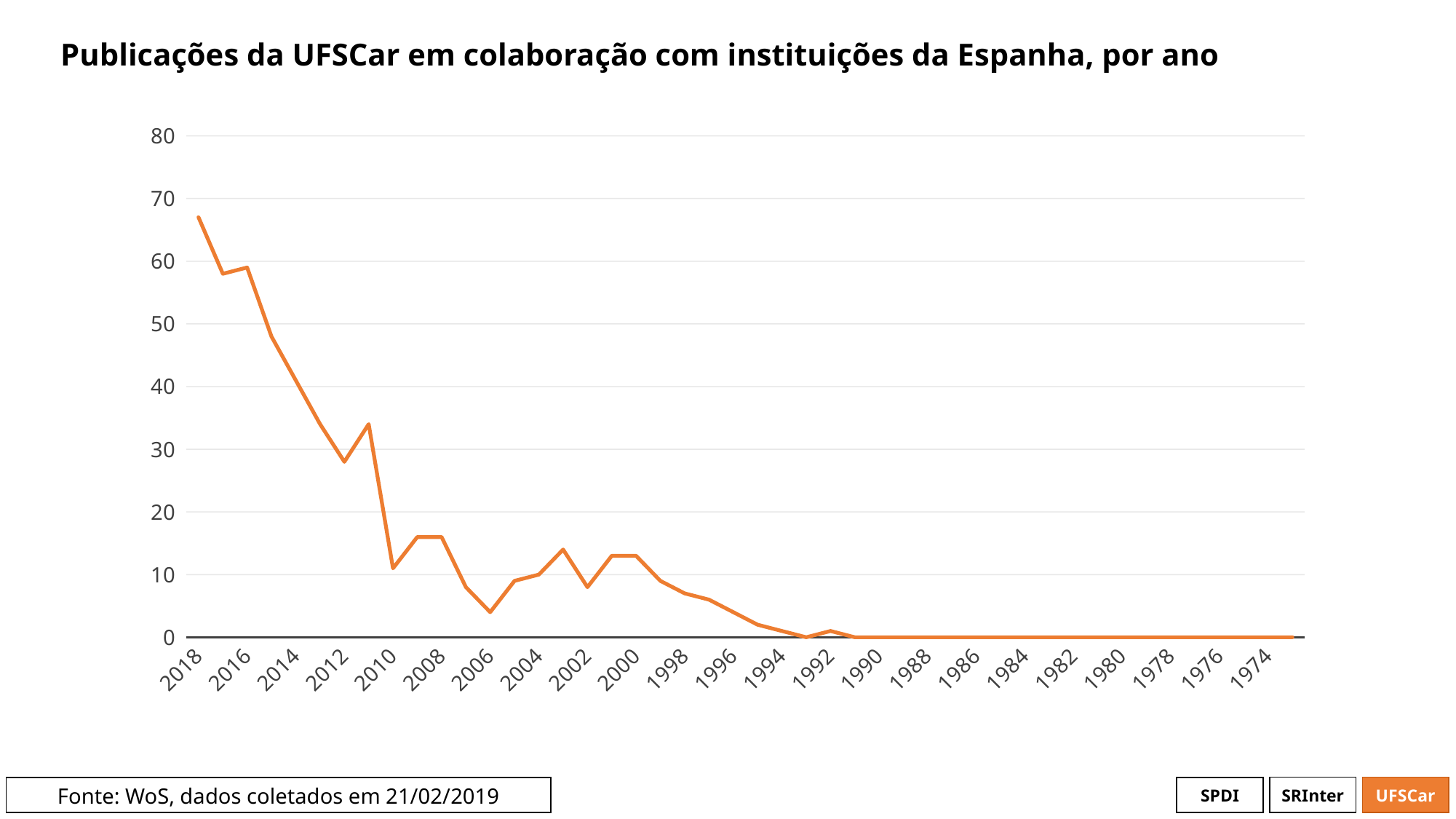
Do the values rise or fall moving from left (2018) to right (1974) along the x axis? fall Is the value for 2008 greater or less than 10? greater Which year has more publications, 2018 or 2012? 2018 What colour is the line in the chart? orange Which year has the highest number of publications? 2018 Is the value for 2012 greater or less than 30? less Is the value for 2018 greater or less than 60? greater Which year has more publications, 2008 or 2006? 2008 What kind of chart is shown on the slide? line chart